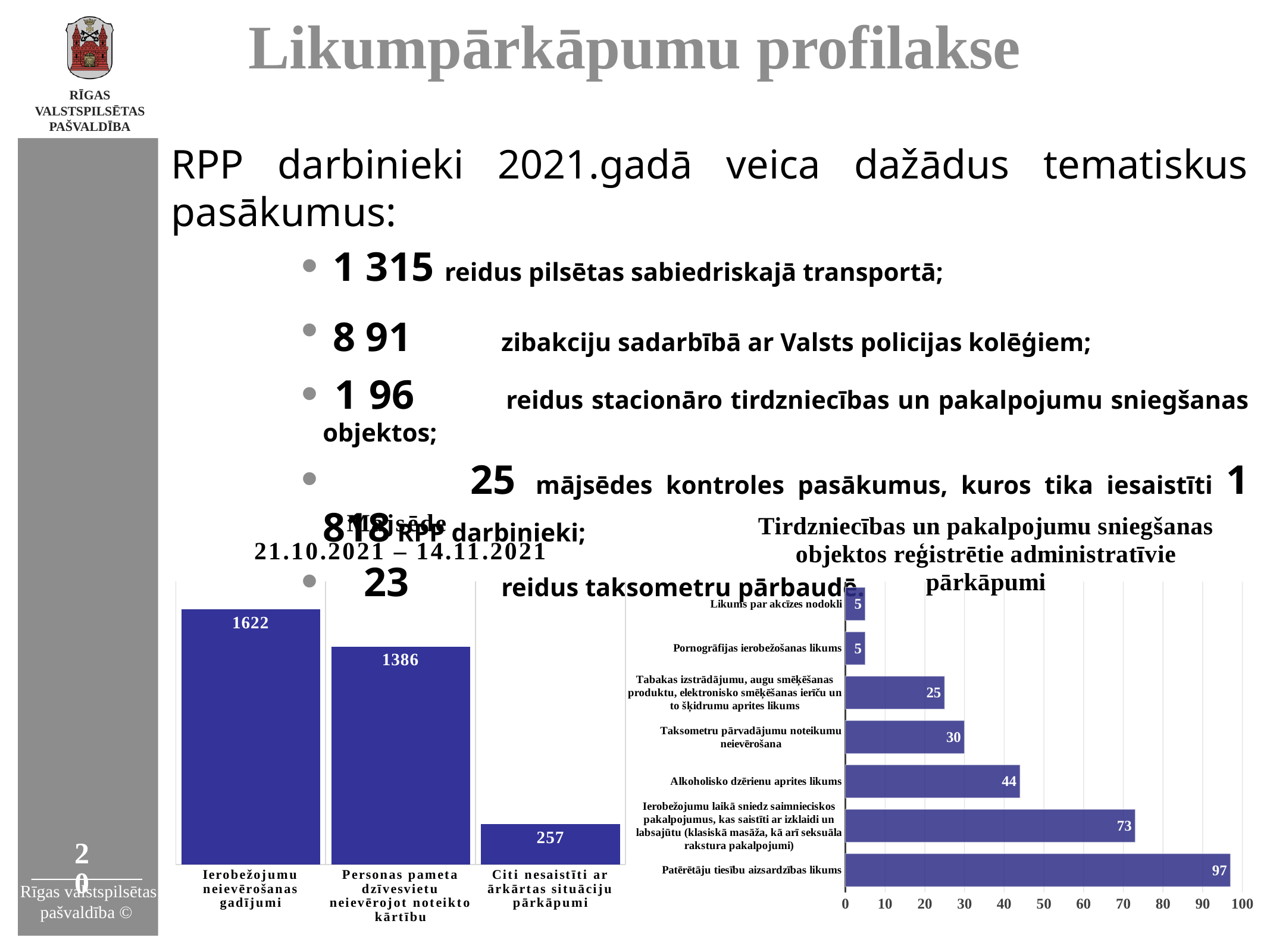
In the left chart, what is the difference between Ierobežojumu neievērošanas gadījumi and Personas pameta dzīvesvietu neievērojot noteikto kārtību? 236 How many bars does the left chart have? 3 In the chart 'Tirdzniecības un pakalpojumu sniegšanas objektos reģistrētie administratīvie pārkāpumi', how many categories are shown? 7 In the chart 'Tirdzniecības un pakalpojumu sniegšanas objektos reģistrētie administratīvie pārkāpumi', what is the difference between Patērētāju tiesību aizsardzības likums and Alkoholisko dzērienu aprites likums? 53 In the chart 'Tirdzniecības un pakalpojumu sniegšanas objektos reģistrētie administratīvie pārkāpumi', which is larger: Taksometru pārvadājumu noteikumu neievērošana or Alkoholisko dzērienu aprites likums? Alkoholisko dzērienu aprites likums In the chart 'Tirdzniecības un pakalpojumu sniegšanas objektos reģistrētie administratīvie pārkāpumi', what is the value for Alkoholisko dzērienu aprites likums? 44 In the chart 'Tirdzniecības un pakalpojumu sniegšanas objektos reģistrētie administratīvie pārkāpumi', which category has the highest value? Patērētāju tiesību aizsardzības likums In the chart 'Tirdzniecības un pakalpojumu sniegšanas objektos reģistrētie administratīvie pārkāpumi', what is the value for Patērētāju tiesību aizsardzības likums? 97 In the left chart, what is the value for Ierobežojumu neievērošanas gadījumi? 1622 In the left chart, which category has the highest value? Ierobežojumu neievērošanas gadījumi What kind of chart is the left chart? bar chart In the left chart, what is the value for Citi nesaistīti ar ārkārtas situāciju pārkāpumi? 257